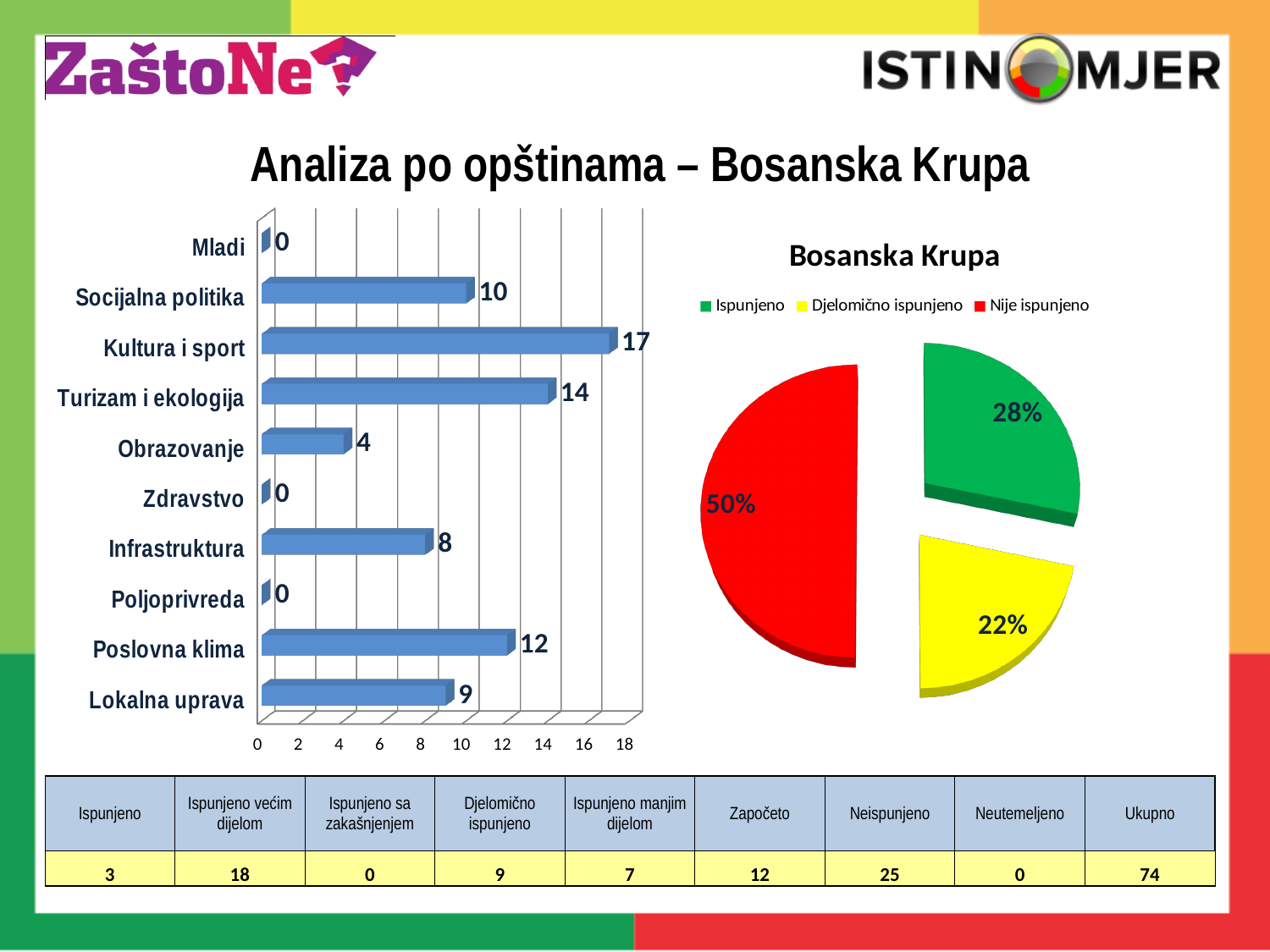
In the pie chart titled Bosanska Krupa, which slice is the smallest? Djelomično ispunjeno In the bar chart on the left, what is the difference between Turizam i ekologija and Obrazovanje? 10 In the bar chart on the left, how many categories are shown? 10 What kind of chart is the chart on the left of the slide? Bar chart In the bar chart on the left, how many categories have a value of 0? 3 In the pie chart titled Bosanska Krupa, what share does Djelomično ispunjeno have? 22% In the bar chart on the left, which is larger, Socijalna politika or Lokalna uprava? Socijalna politika In the bar chart on the left, which category has the highest value? Kultura i sport How many entries does the legend of the pie chart titled Bosanska Krupa list? 3 In the bar chart on the left, what is the value for Poslovna klima? 12 In the pie chart titled Bosanska Krupa, what share does Nije ispunjeno have? 50% In the bar chart on the left, what is the value for Kultura i sport? 17